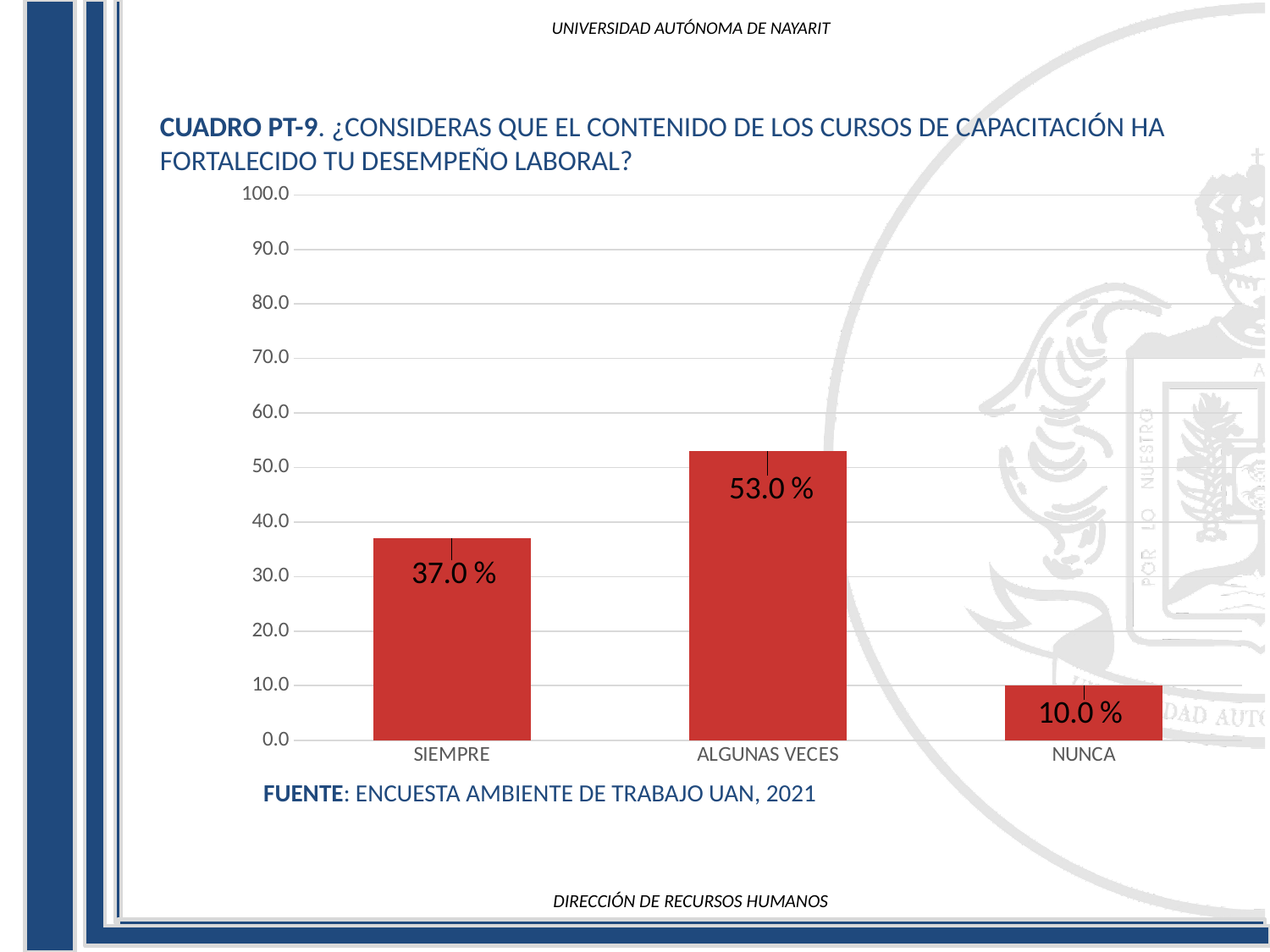
Is the value for ALGUNAS VECES greater or less than 50.0? greater What is the value for NUNCA? 10.0 % How many categories are shown on the x axis? 3 What is the source cited below the chart? ENCUESTA AMBIENTE DE TRABAJO UAN, 2021 What is the difference between the values for ALGUNAS VECES and SIEMPRE? 16.0 % What is the value for ALGUNAS VECES? 53.0 % Which category has the highest value? ALGUNAS VECES What is the value for SIEMPRE? 37.0 % Which is larger, the value for SIEMPRE or the value for NUNCA? SIEMPRE What is the difference between the values for SIEMPRE and NUNCA? 27.0 % Which category has the lowest value? NUNCA What kind of chart is shown on the slide? bar chart